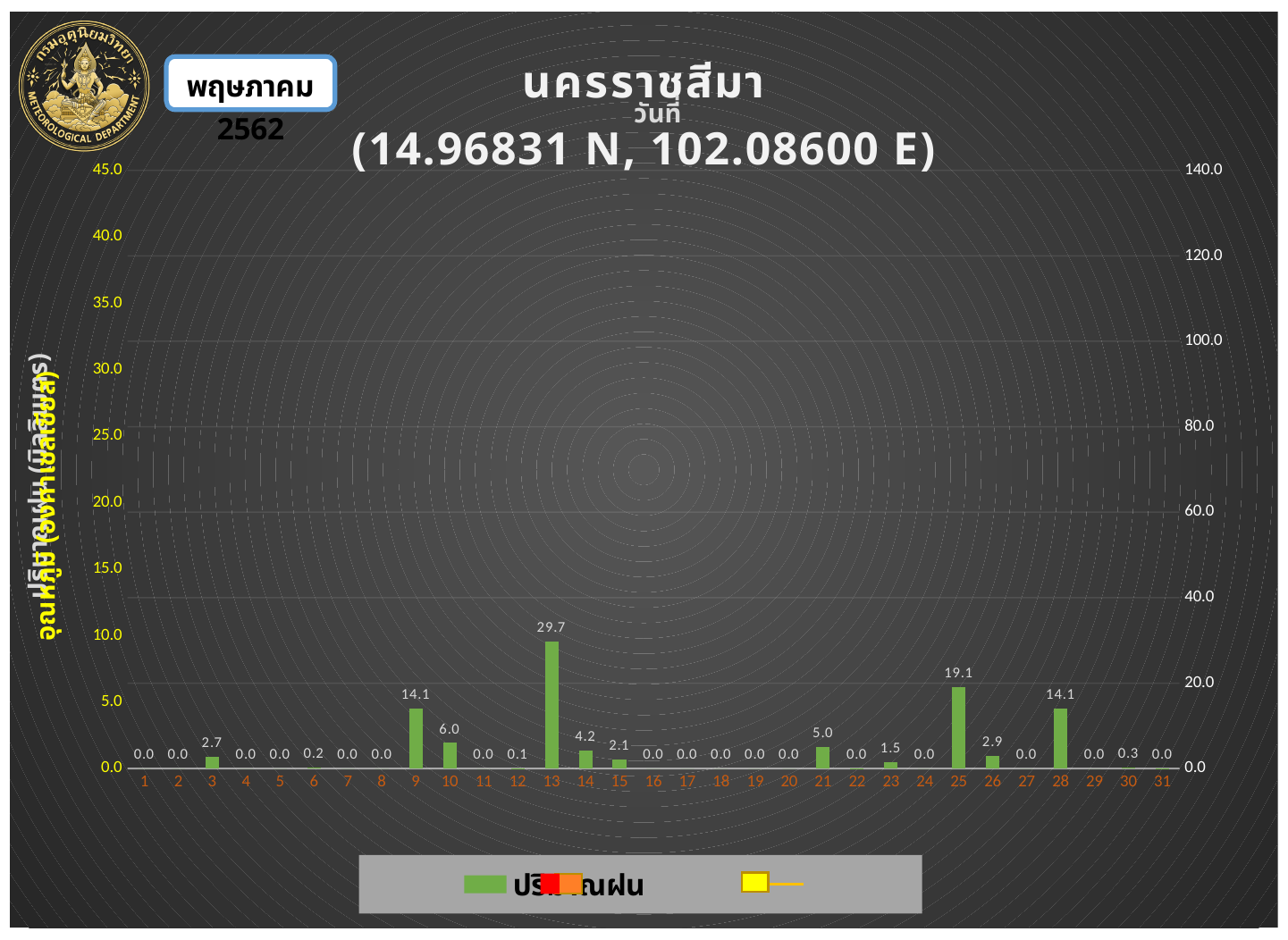
Which day has the highest rainfall value? 13 What is the difference between the rainfall values for day 13 and day 25? 10.6 What is the difference between the rainfall values for day 9 and day 10? 8.1 Which is larger, the rainfall value for day 14 or for day 26? day 14 What is the rainfall value shown for day 25? 19.1 What is the rainfall value shown for day 21? 5.0 How many days (categories) are shown on the x axis? 31 What is the rainfall value shown for day 10? 6.0 What is the rainfall value shown for day 13? 29.7 What coordinates are given in the chart title? 14.96831 N, 102.08600 E What kind of chart is used to show the rainfall values? bar chart Which is larger, the rainfall value for day 3 or for day 23? day 3